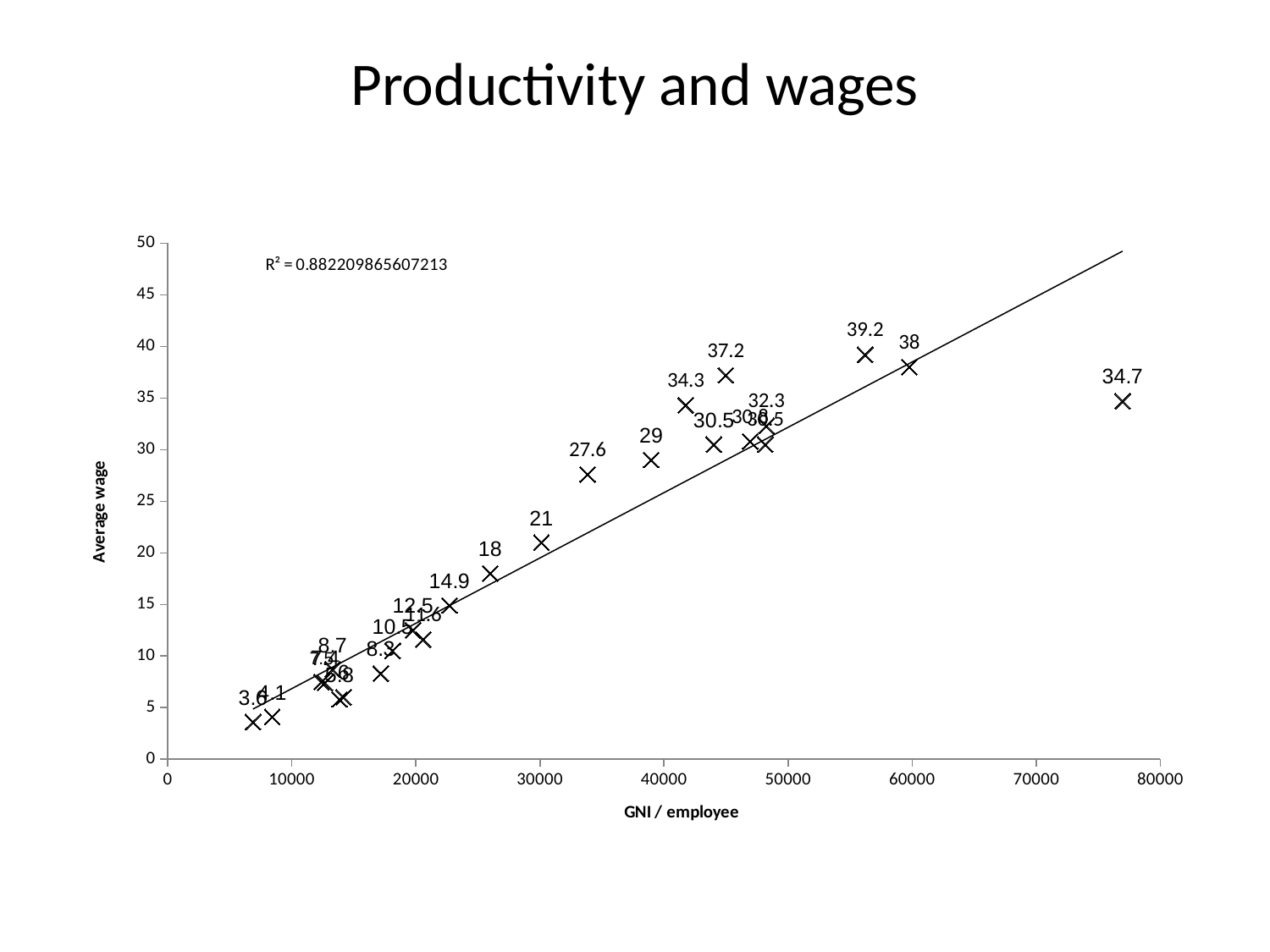
What is the difference between the two highest labelled values, 39.2 and 38? 1.2 Which is larger, the point labelled 37.2 or the point labelled 34.3? 37.2 What is the label of the horizontal axis? GNI / employee Do average wages generally rise or fall as GNI per employee increases along the x axis? rise What is the highest labelled average wage value on the chart? 39.2 What is the labelled average wage of the point at roughly 60000 GNI per employee? 38 What is the labelled average wage of the point at roughly 30000 GNI per employee? 21 Is the average wage for the point at roughly 77000 GNI per employee greater or less than 30? greater What is the title of the chart? Productivity and wages What kind of chart is shown on the slide? scatter chart What is the labelled average wage of the point with the highest GNI per employee (around 77000)? 34.7 What is the lowest labelled average wage value on the chart? 3.6